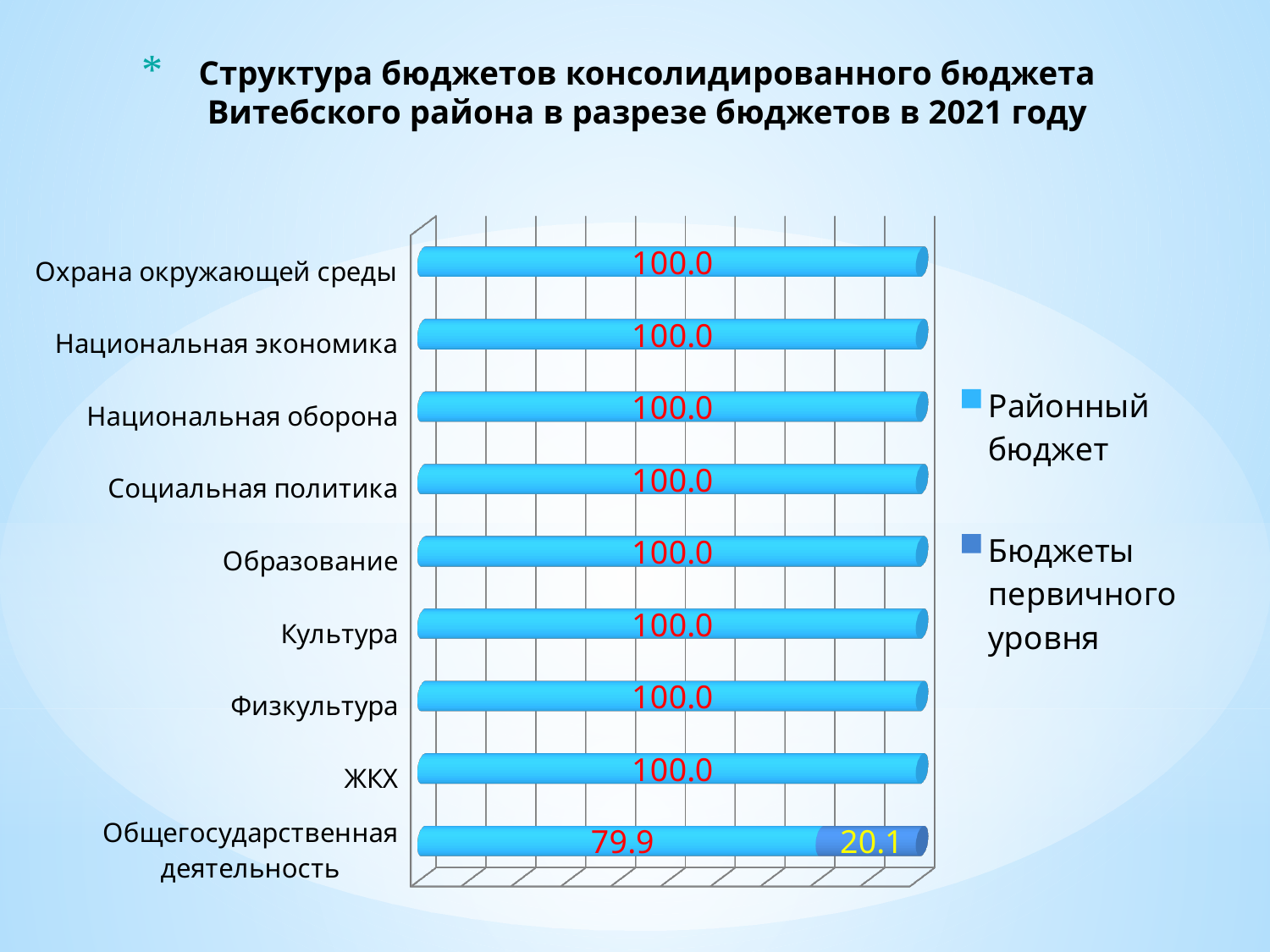
How many series does the legend list? 2 What are the two legend entries of the chart? Районный бюджет; Бюджеты первичного уровня What is the value of Районный бюджет for Образование? 100.0 What type of chart is shown on the slide? bar chart What is the value of Бюджеты первичного уровня for Общегосударственная деятельность? 20.1 What is the value of Районный бюджет for Общегосударственная деятельность? 79.9 What is the value of Районный бюджет for ЖКХ? 100.0 Which is larger for Общегосударственная деятельность: Районный бюджет or Бюджеты первичного уровня? Районный бюджет How many categories are shown on the chart? 9 What is the total of the stacked bar for Общегосударственная деятельность? 100.0 Which category has the lowest value for Районный бюджет? Общегосударственная деятельность What is the difference between the Районный бюджет and Бюджеты первичного уровня values for Общегосударственная деятельность? 59.8